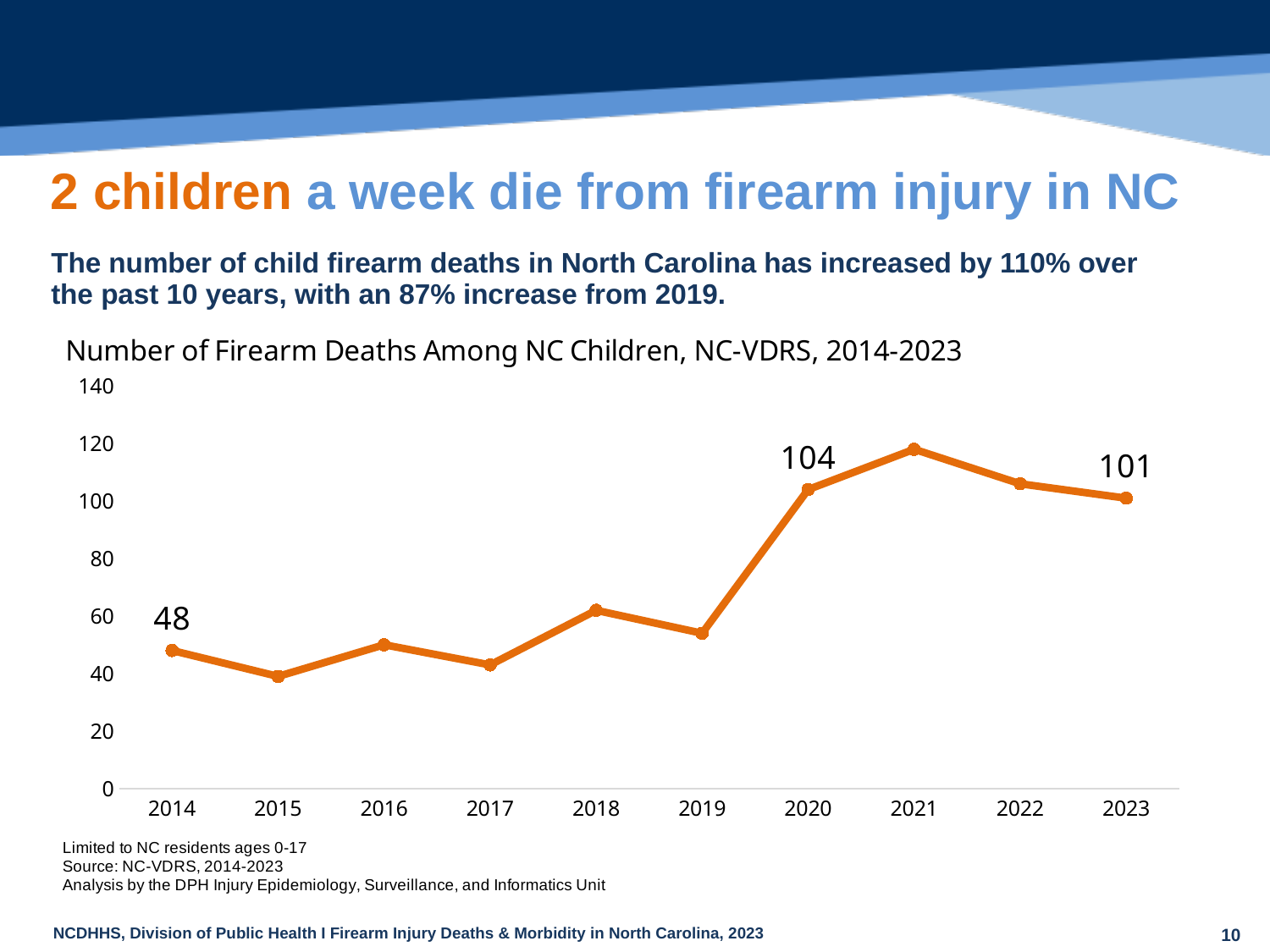
Is the value for 2015 greater or less than 60? less What is the difference between the number of firearm deaths in 2020 and in 2014? 56 Which year has more firearm deaths among NC children, 2014 or 2023? 2023 What is the number of firearm deaths among NC children in 2020? 104 What is the difference between the number of firearm deaths in 2020 and in 2023? 3 Which year has the highest number of firearm deaths among NC children? 2021 Overall, do the number of firearm deaths among NC children rise or fall from 2014 to 2023? rise Is the value for 2021 greater or less than 100? greater What is the number of firearm deaths among NC children in 2023? 101 How many years are plotted on the chart? 10 What is the number of firearm deaths among NC children in 2014? 48 What kind of chart is shown on the slide? line chart